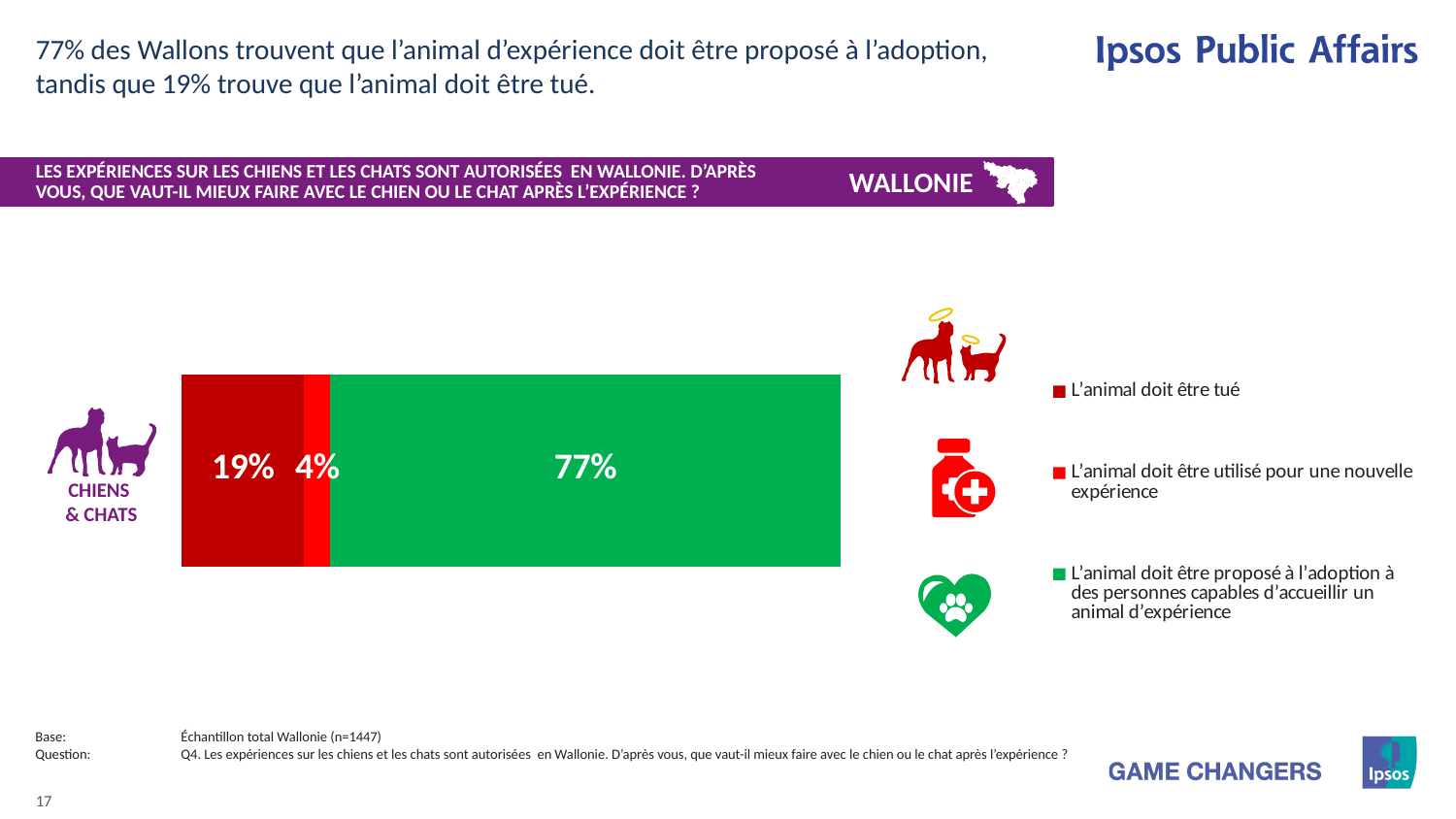
What is the total of the three segments in the stacked bar? 100% What is the difference in percentage points between 'L'animal doit être proposé à l'adoption' and 'L'animal doit être tué'? 58 percentage points What colour is the segment for 'L'animal doit être proposé à l'adoption'? Green Which response option has the lowest share in the chart? L'animal doit être utilisé pour une nouvelle expérience What percentage of respondents say the animal should be offered for adoption (L'animal doit être proposé à l'adoption)? 77% What is the difference in percentage points between 'L'animal doit être tué' and 'L'animal doit être utilisé pour une nouvelle expérience'? 15 percentage points Which response option has the highest share in the chart? L'animal doit être proposé à l'adoption à des personnes capables d'accueillir un animal d'expérience What percentage of respondents say the animal should be killed (L'animal doit être tué)? 19% Which is larger: the share for 'L'animal doit être tué' or the share for 'L'animal doit être utilisé pour une nouvelle expérience'? L'animal doit être tué What percentage of respondents say the animal should be used for a new experiment (L'animal doit être utilisé pour une nouvelle expérience)? 4% What kind of chart is shown on the slide? Stacked bar chart How many series does the legend list? 3